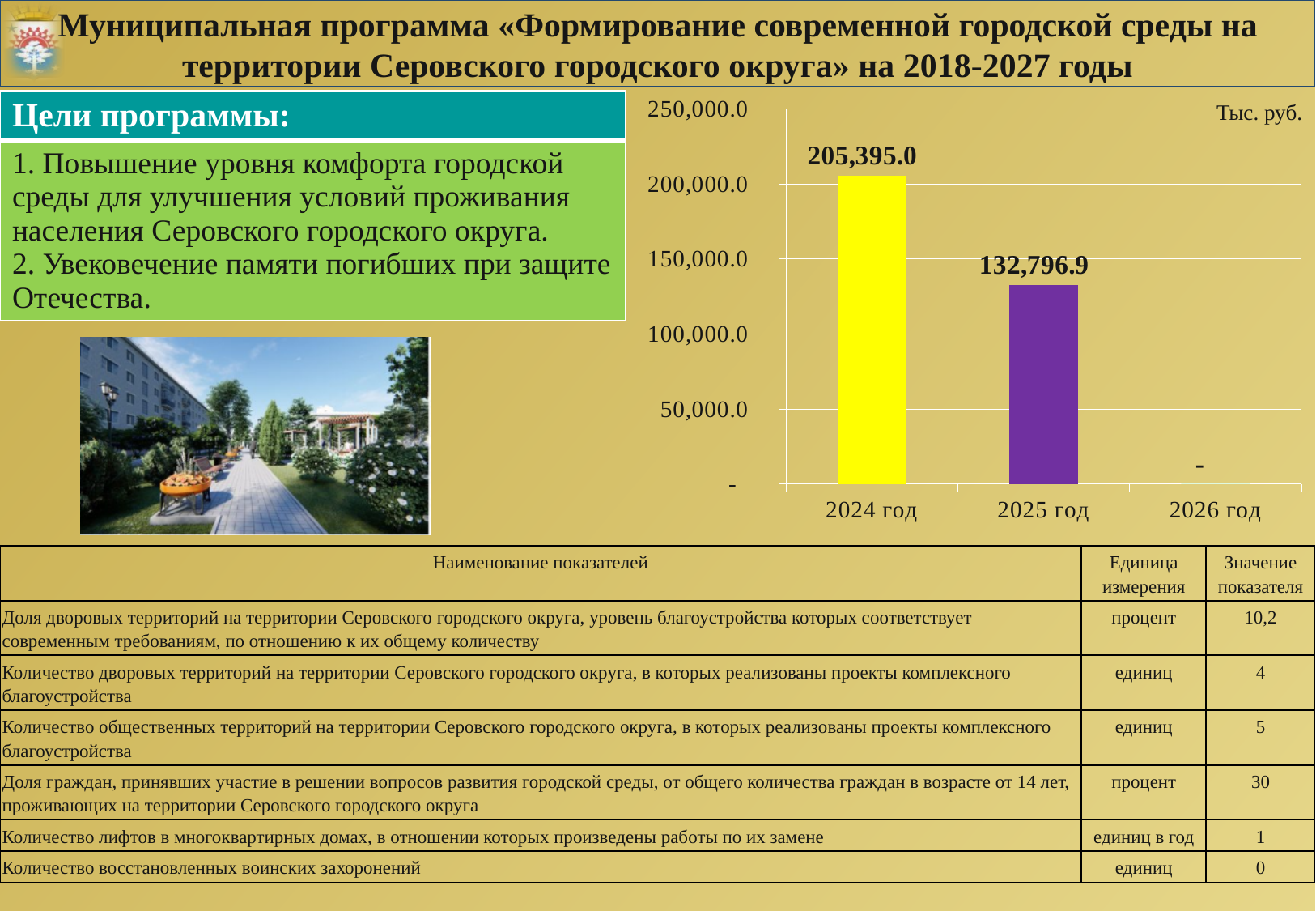
What unit of measurement is indicated in the top right corner of the chart? Тыс. руб. What is the value shown for 2025 год on the chart? 132,796.9 How many year categories are shown on the x axis of the chart? 3 Which year has the lowest value on the chart? 2026 год Which is larger, the value for 2024 год or the value for 2025 год? 2024 год What is the difference between the values for 2024 год and 2025 год? 72,598.1 What is the data label shown for 2026 год on the chart? - Is the value for 2024 год greater or less than 200,000.0? greater Is the value for 2025 год greater or less than 150,000.0? less Which year has the highest value on the chart? 2024 год What type of chart is shown on the slide? bar chart What is the value shown for 2024 год on the chart? 205,395.0